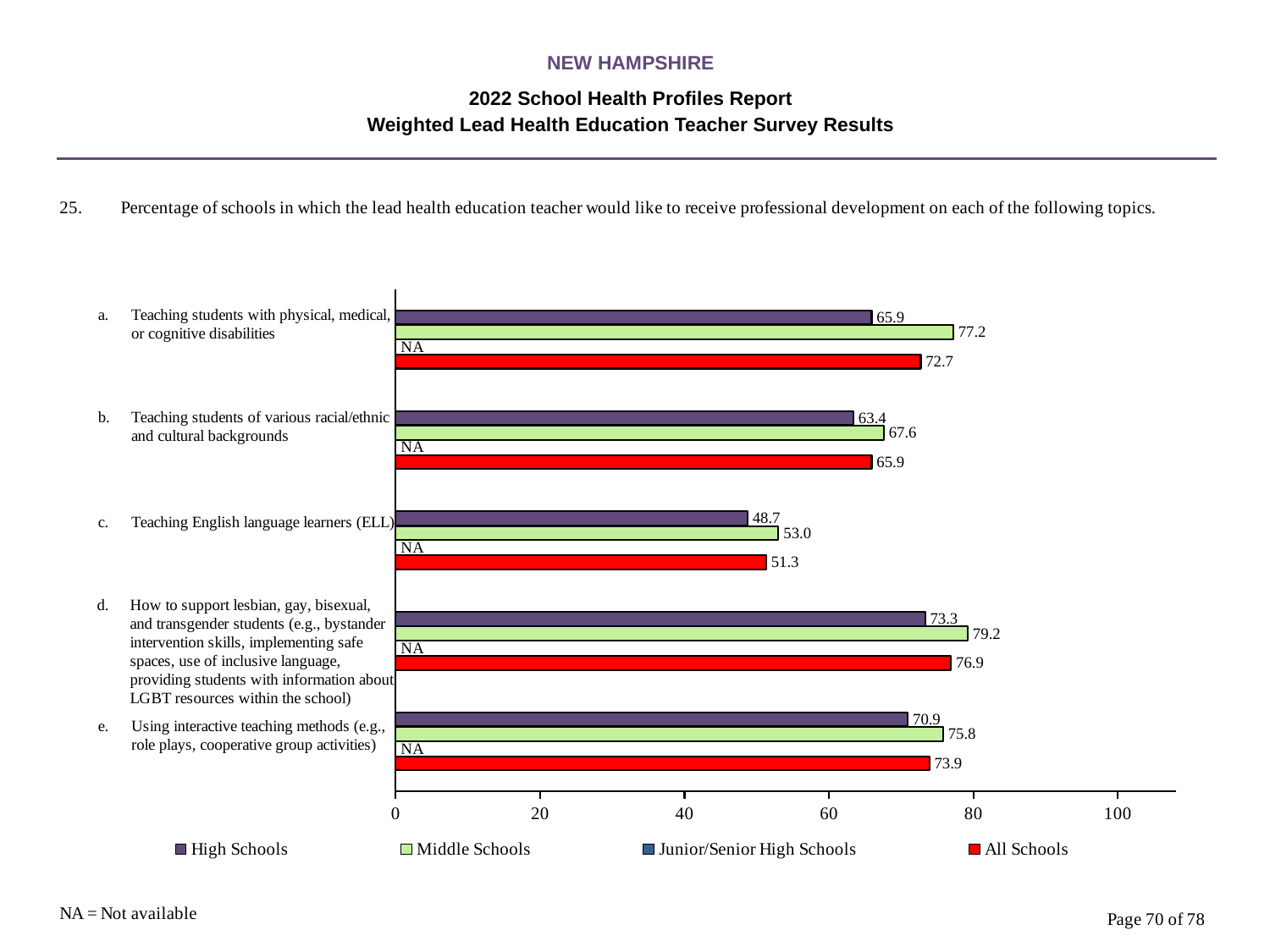
What kind of chart is shown on the slide? bar chart Which topic has the lowest High Schools value? Teaching English language learners (ELL) Which topic has the highest Middle Schools value? How to support lesbian, gay, bisexual, and transgender students What value is shown for Junior/Senior High Schools for each topic? NA How many topics are listed on the chart? 5 How many series does the legend list? 4 What is the All Schools value for teaching English language learners (ELL)? 51.3 What is the Middle Schools value for teaching students with physical, medical, or cognitive disabilities? 77.2 Which is larger for teaching English language learners (ELL): the High Schools value or the Middle Schools value? Middle Schools Is the All Schools value for using interactive teaching methods greater or less than 60? greater What is the High Schools value for using interactive teaching methods? 70.9 What is the difference between the Middle Schools and High Schools values for teaching students of various racial/ethnic and cultural backgrounds? 4.2